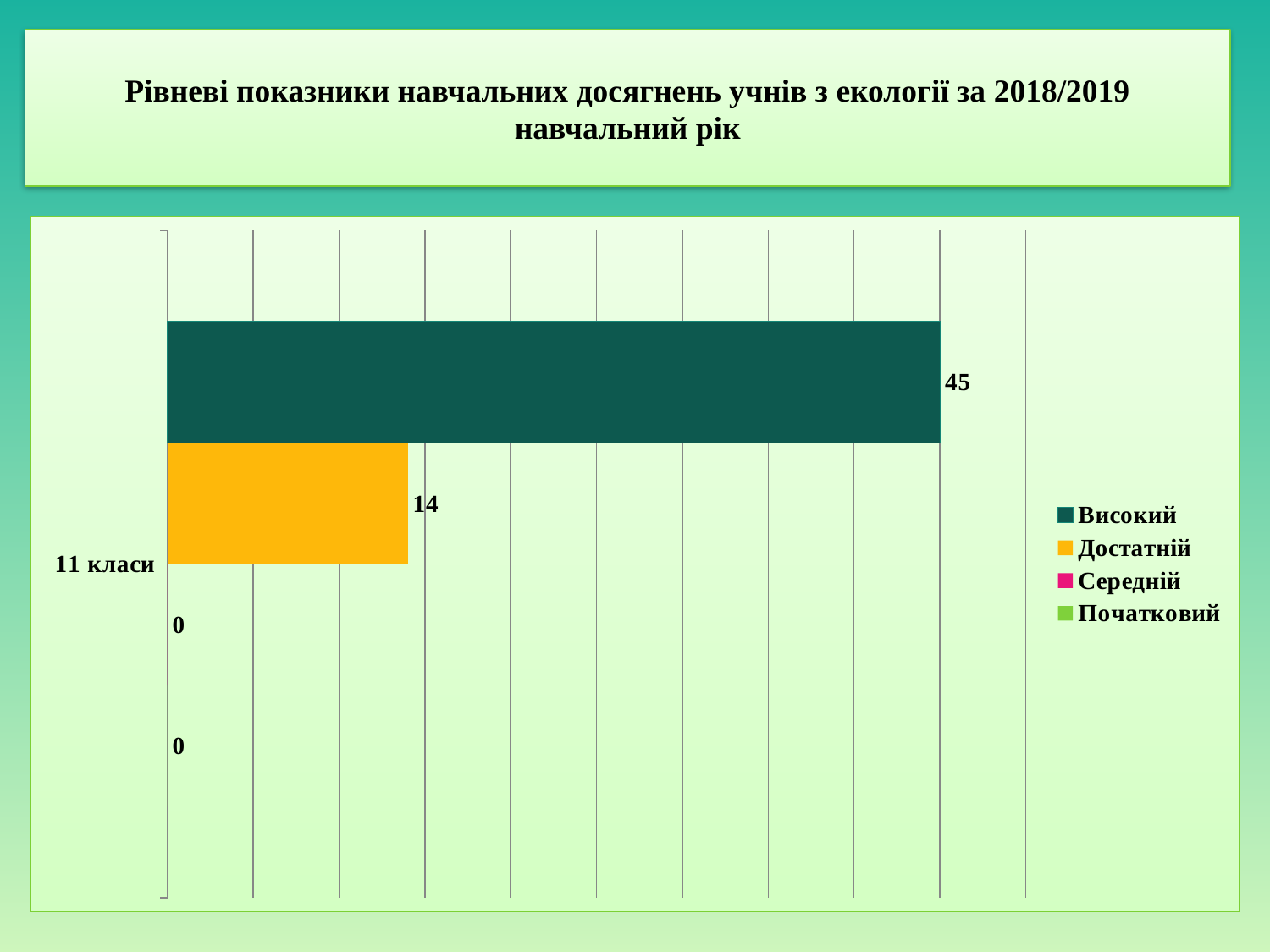
How many series does the legend list? 4 What is the value for Початковий for 11 класи? 0 What is the title of the slide? Рівневі показники навчальних досягнень учнів з екології за 2018/2019 навчальний рік Which series has the highest value for 11 класи? Високий What is the value for Достатній for 11 класи? 14 What colour is the bar for Достатній? Yellow/orange How many categories are shown on the category axis? 1 What is the value for Високий for 11 класи? 45 What is the difference between the Високий and Достатній values for 11 класи? 31 What kind of chart is shown on the slide? Bar chart Which is larger for 11 класи, Високий or Достатній? Високий What is the value for Середній for 11 класи? 0